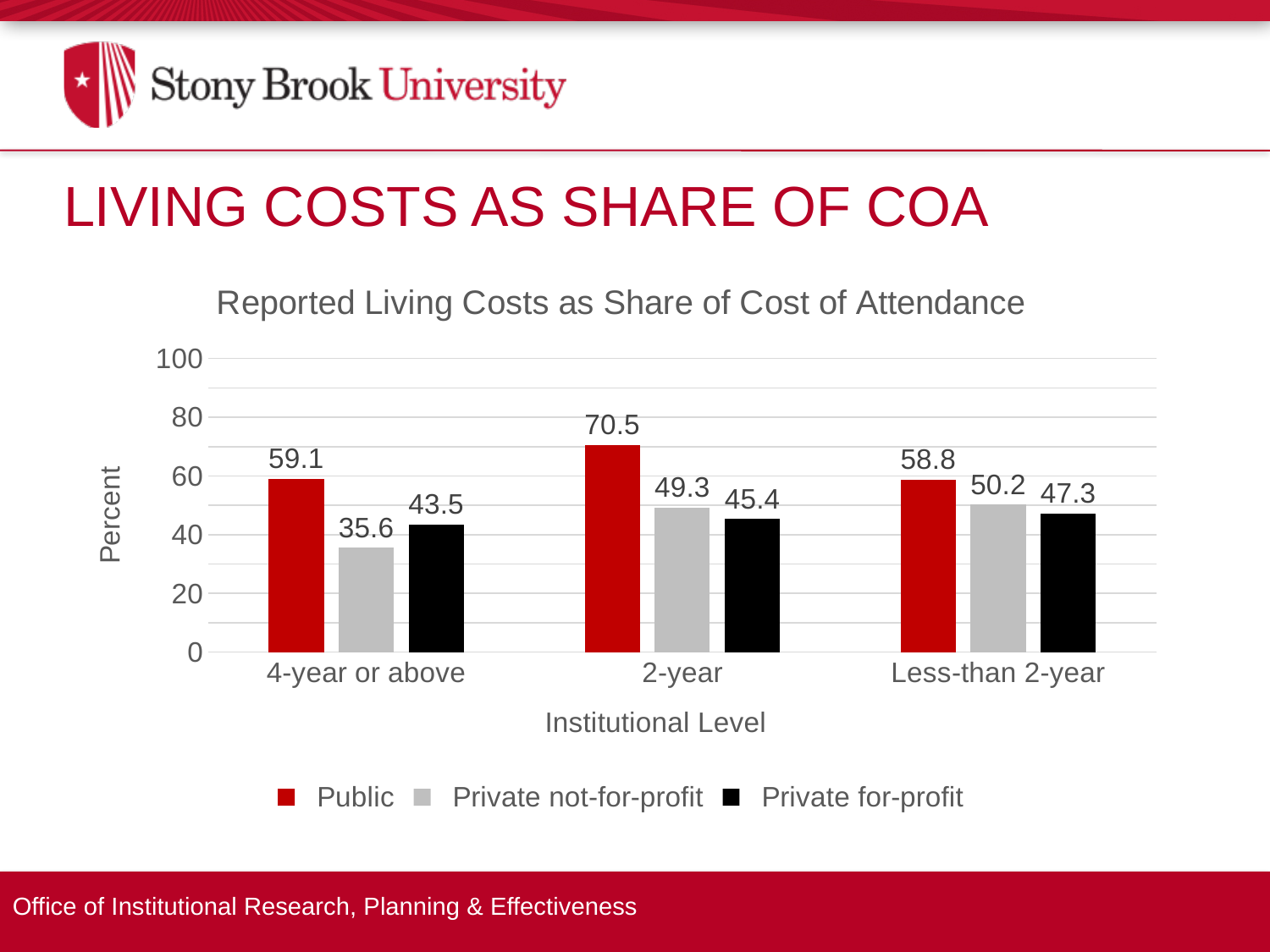
How many series does the legend list? 3 What is the difference between the Public and Private not-for-profit values at 4-year or above? 23.5 What is the value for Private for-profit at Less-than 2-year? 47.3 Is the value for Public at 2-year greater or less than 60? greater Which institutional level has the highest Public value? 2-year What is the title of the chart? Reported Living Costs as Share of Cost of Attendance Which institutional level has the lowest Private not-for-profit value? 4-year or above What is the value for Private not-for-profit at 4-year or above? 35.6 How many institutional level categories are shown on the x axis? 3 Which is larger at Less-than 2-year: Private not-for-profit or Private for-profit? Private not-for-profit What kind of chart is shown? bar chart What is the value for Public at 2-year? 70.5